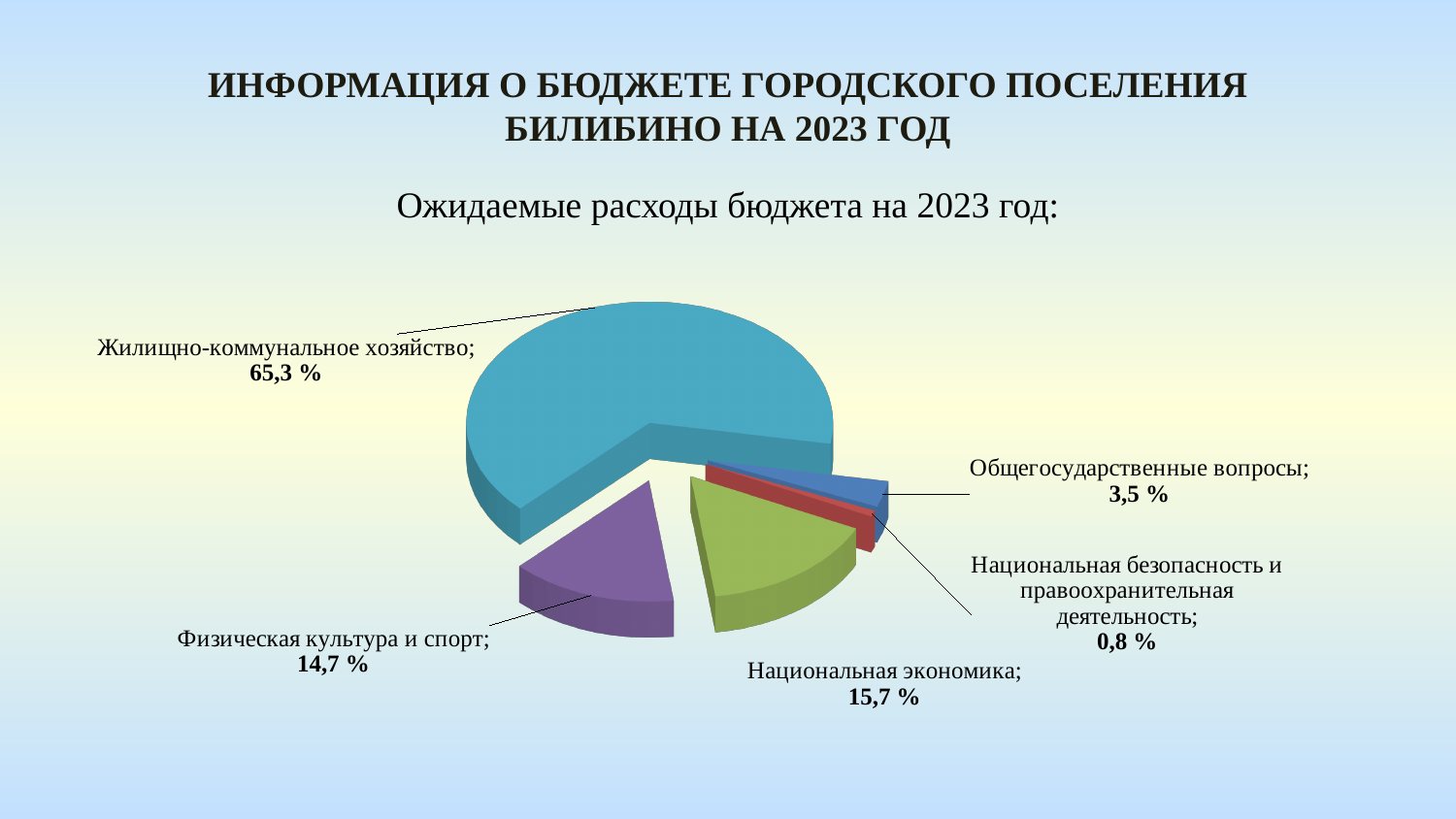
What is the value shown for Общегосударственные вопросы? 3,5 % How many categories are shown in the pie chart? 5 What kind of chart is shown on the slide? Pie chart What share of the pie does Жилищно-коммунальное хозяйство have? 65,3 % What colour is the slice for Жилищно-коммунальное хозяйство? Blue (teal) Which is larger: the share of Общегосударственные вопросы or the share of Национальная безопасность и правоохранительная деятельность? Общегосударственные вопросы Which category has the largest slice of the pie? Жилищно-коммунальное хозяйство What is the difference between the shares of Национальная экономика and Физическая культура и спорт? 1,0 % Which category has the smallest slice of the pie? Национальная безопасность и правоохранительная деятельность What is the value shown for Физическая культура и спорт? 14,7 % What is the value shown for Национальная экономика? 15,7 % What is the value shown for Национальная безопасность и правоохранительная деятельность? 0,8 %